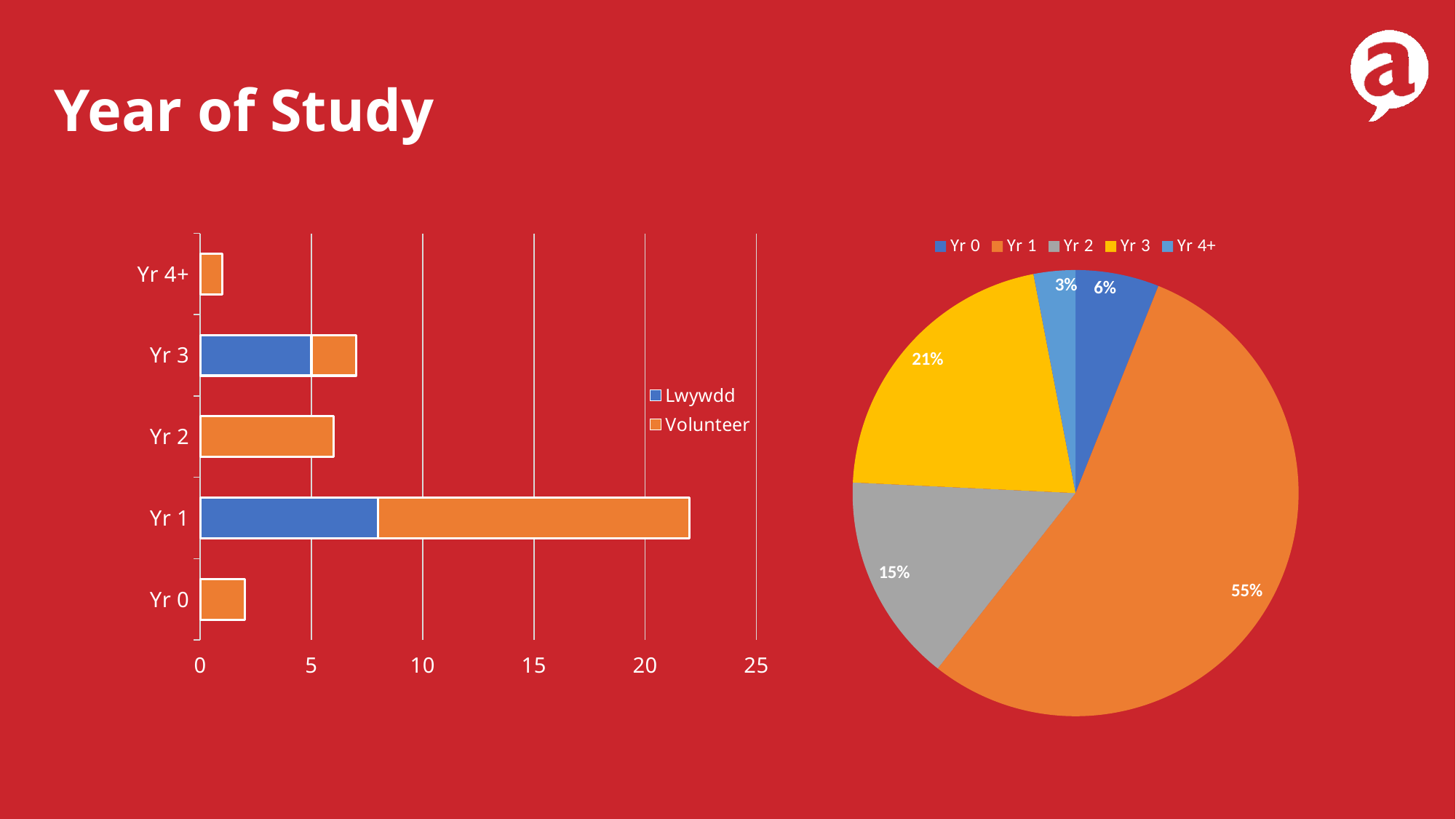
In the bar chart on the left, is the value for Yr 0 greater or less than 5? less In the pie chart on the right, which slice is larger, Yr 0 or Yr 2? Yr 2 In the bar chart on the left, is the total length of the Yr 1 bar greater or less than 20? greater In the pie chart on the right, which year of study has the smallest slice? Yr 4+ What kind of chart is on the left of the slide? bar chart In the pie chart on the right, what is the difference in percentage points between the Yr 3 and Yr 2 slices? 6 In the pie chart on the right, what share does Yr 3 have? 21% How many slices does the pie chart on the right have? 5 How many series does the legend of the bar chart on the left list? 2 In the pie chart on the right, what share does Yr 4+ have? 3% In the pie chart on the right, which year of study has the largest slice? Yr 1 In the pie chart on the right, what share does Yr 1 have? 55%